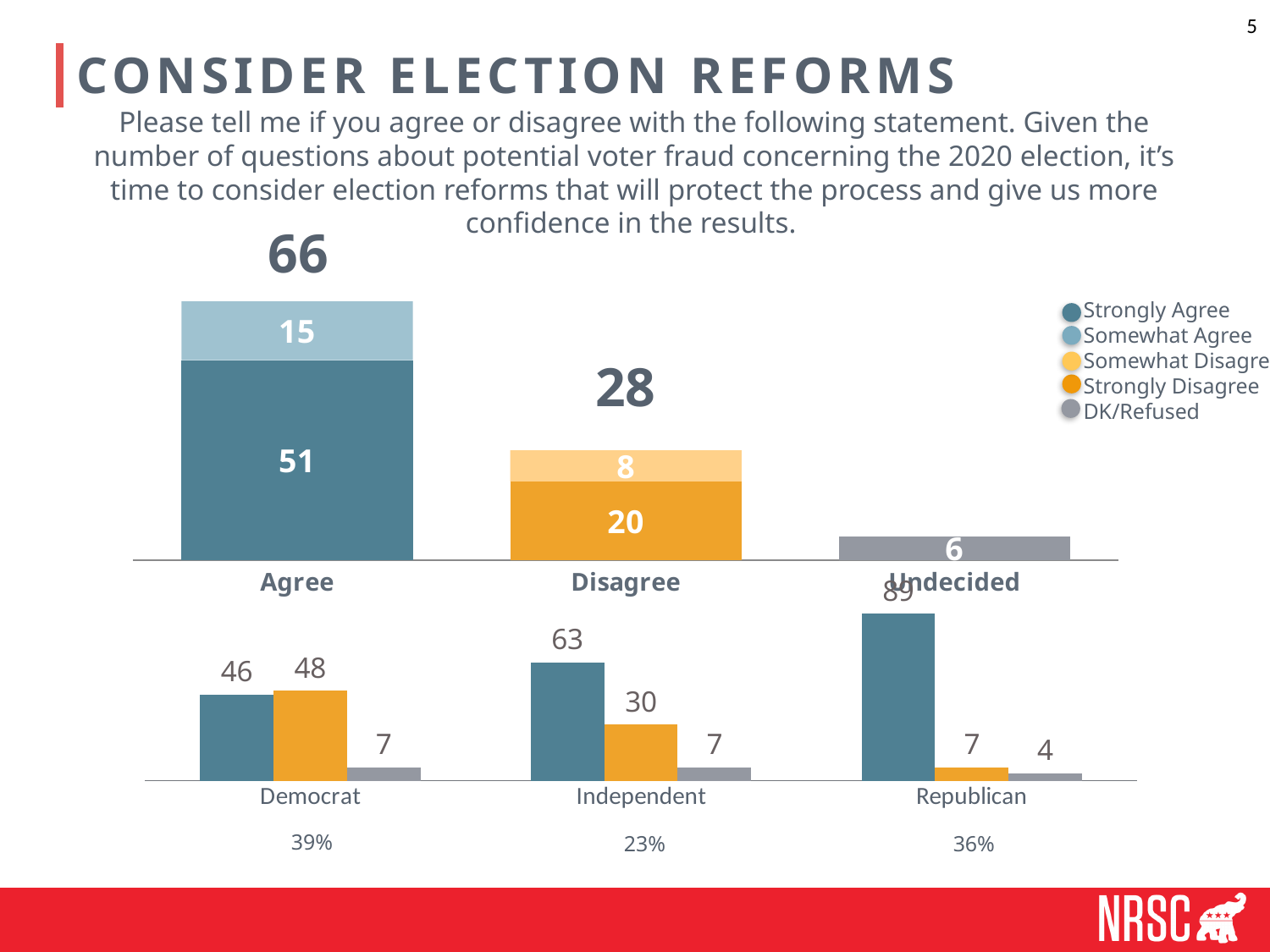
In the top chart, how many entries does the legend list? 5 In the bottom chart, how many party categories are shown on the x axis? 3 What kind of chart is the bottom chart? bar chart In the bottom chart, which is larger for Democrat: the blue bar or the orange bar? the orange bar (48) In the top chart, which category has the lowest total? Undecided In the top chart, what is the Strongly Agree value within the Agree bar? 51 In the bottom chart, what is the value of the blue bar for Republican? 89 In the top chart, what is the Somewhat Disagree value within the Disagree bar? 8 In the bottom chart, what is the value of the orange bar for Independent? 30 In the top chart, what is the total for the Agree bar? 66 In the top chart, what is the difference between the Agree total and the Disagree total? 38 In the top chart, what is the value for Undecided? 6